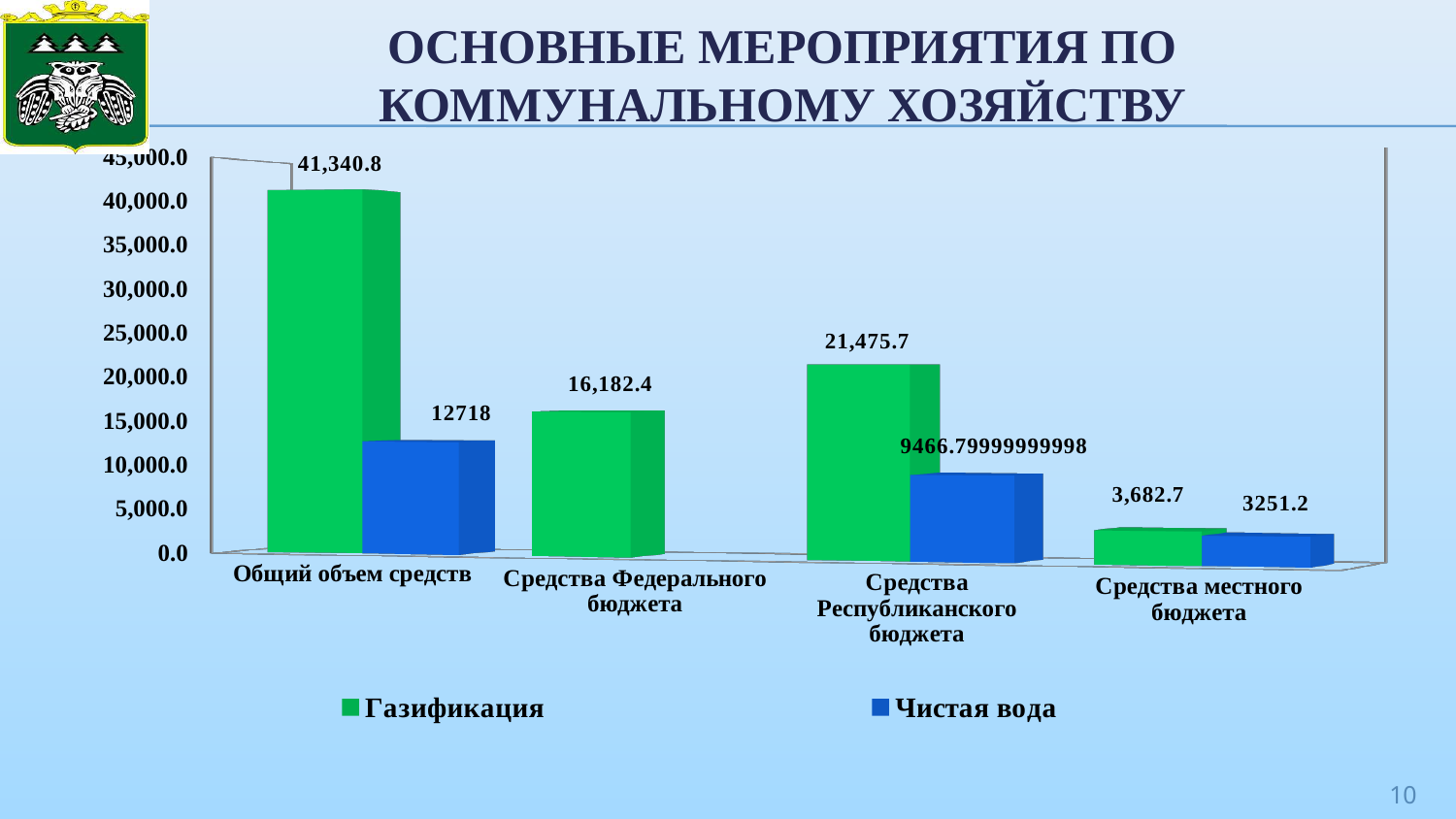
What is the difference between the Газификация and Чистая вода values for Общий объем средств? 28,622.8 Which category has the highest Чистая вода value? Общий объем средств How many series does the legend list? 2 How many categories are shown on the x axis? 4 What kind of chart is shown on the slide? Bar chart What is the value of Газификация for Средства Федерального бюджета? 16,182.4 Which category has the lowest Газификация value? Средства местного бюджета What is the value of Чистая вода for Средства местного бюджета? 3251.2 Which is larger: Газификация for Средства Республиканского бюджета or Газификация for Средства Федерального бюджета? Средства Республиканского бюджета What is the value of Чистая вода for Средства Республиканского бюджета? 9466.79999999998 What is the value of Газификация for Общий объем средств? 41,340.8 What is the value of Чистая вода for Общий объем средств? 12718